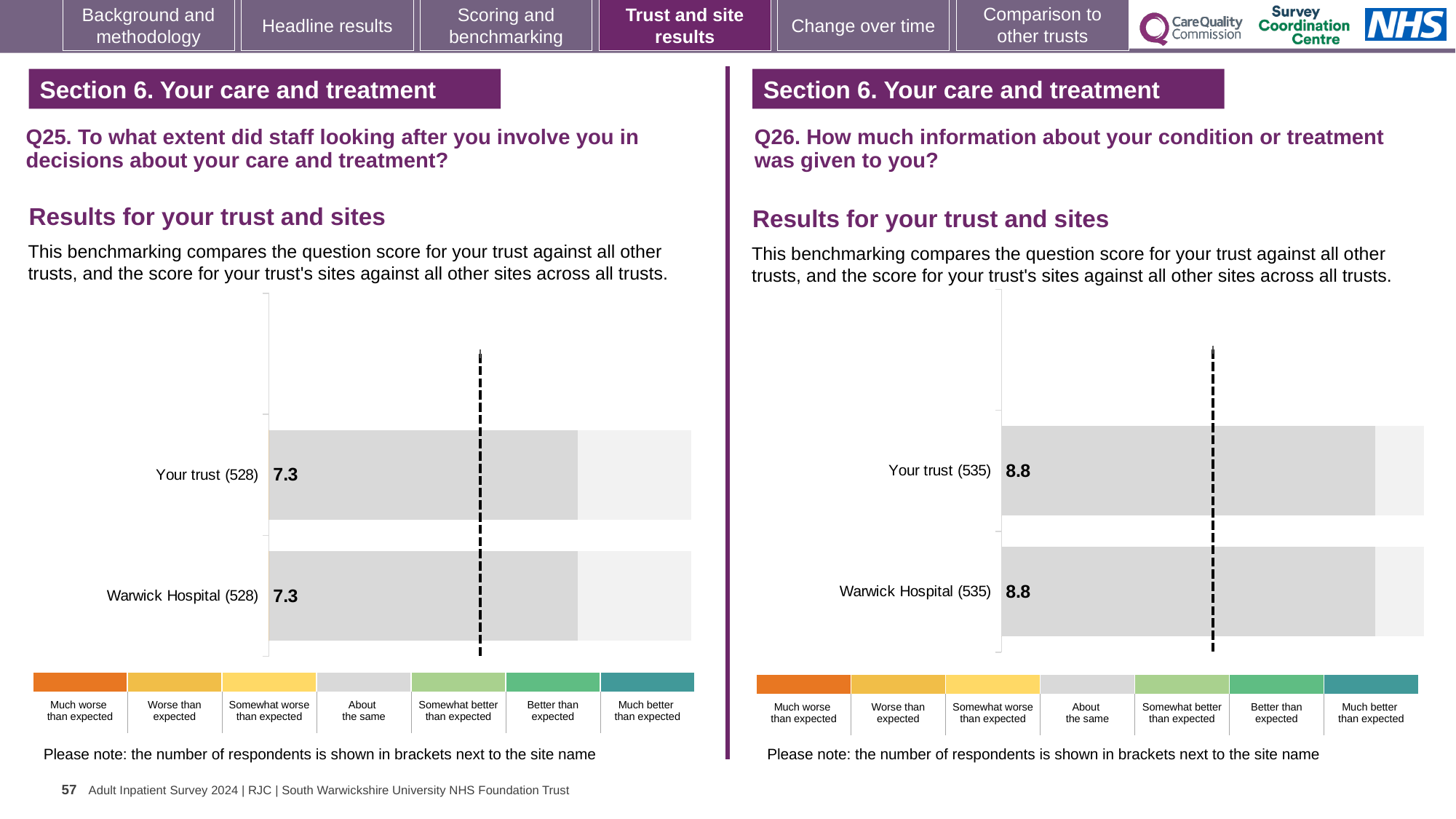
On the Q25 chart (left), how many respondents are shown in brackets for Your trust? 528 On the Q26 chart (right), which category does the colour key label for the grey band represent? About the same What kind of chart is the Q25 chart on the left? Bar chart On the Q26 chart (right), what is the score for Your trust? 8.8 On the Q25 chart (left), what is the score for Your trust? 7.3 On the Q26 chart (right), how many bars are plotted? 2 On the Q26 chart (right), what is the difference between the Your trust score and the Warwick Hospital score? 0 On the Q25 chart (left), how many bars are plotted? 2 On the Q26 chart (right), what is the score for Warwick Hospital? 8.8 On the Q26 chart (right), how many respondents are shown in brackets for Warwick Hospital? 535 On the Q25 chart (left), what is the difference between the Your trust score and the Warwick Hospital score? 0 On the Q25 chart (left), what is the score for Warwick Hospital? 7.3